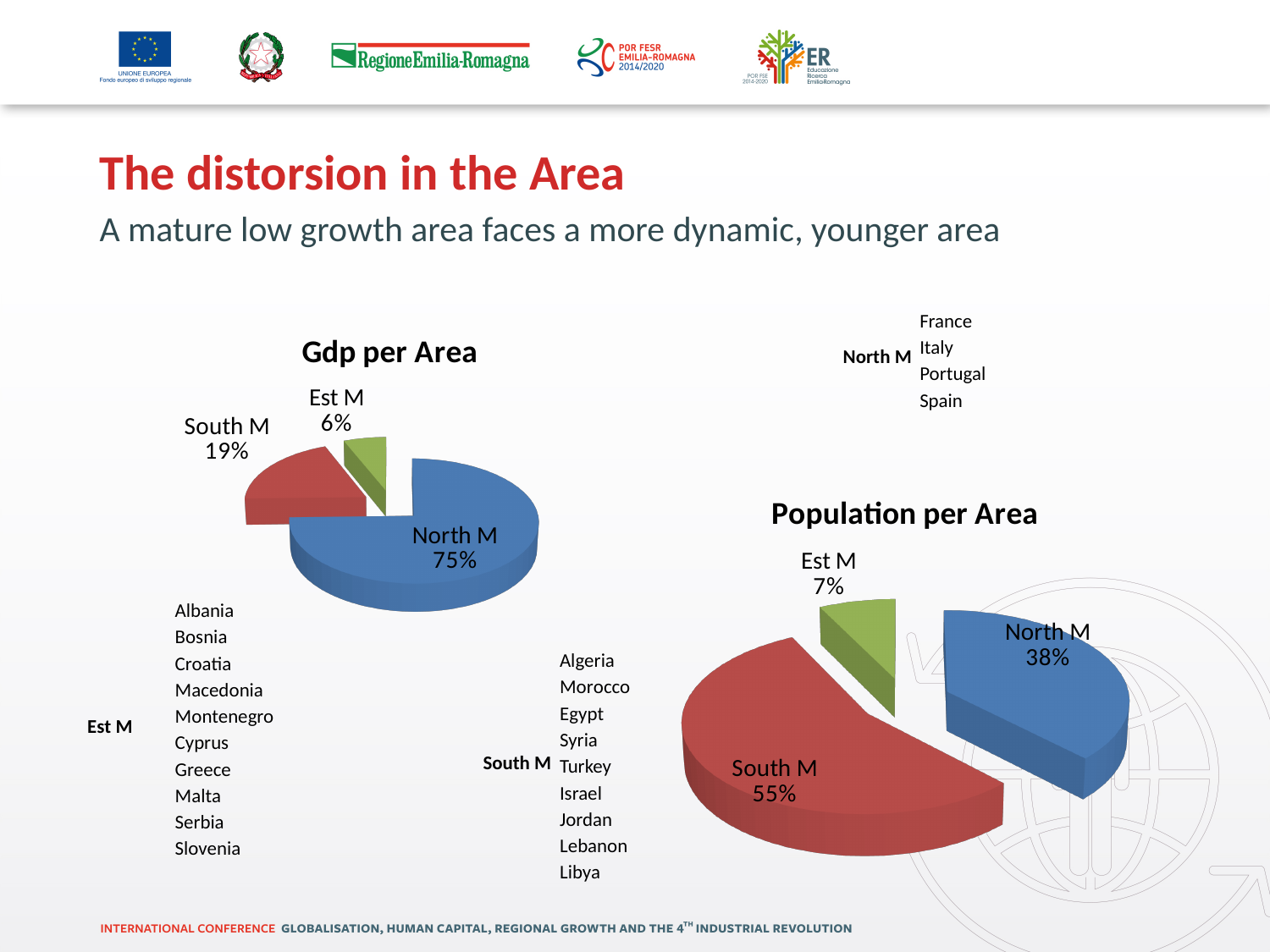
In the 'Gdp per Area' chart, what share does South M have? 19% How many slices does the 'Gdp per Area' chart have? 3 In the 'Gdp per Area' chart, which area has the largest share? North M What kind of chart is the 'Population per Area' chart? Pie chart In the 'Population per Area' chart, what share does Est M have? 7% In the 'Population per Area' chart, what is the difference between the South M and North M shares? 17% In the 'Population per Area' chart, what share does South M have? 55% In the 'Gdp per Area' chart, what share does North M have? 75% In the 'Population per Area' chart, what share does North M have? 38% In the 'Gdp per Area' chart, which is larger, the share for South M or the share for Est M? South M In the 'Gdp per Area' chart, what share does Est M have? 6% In the 'Population per Area' chart, which area has the smallest share? Est M